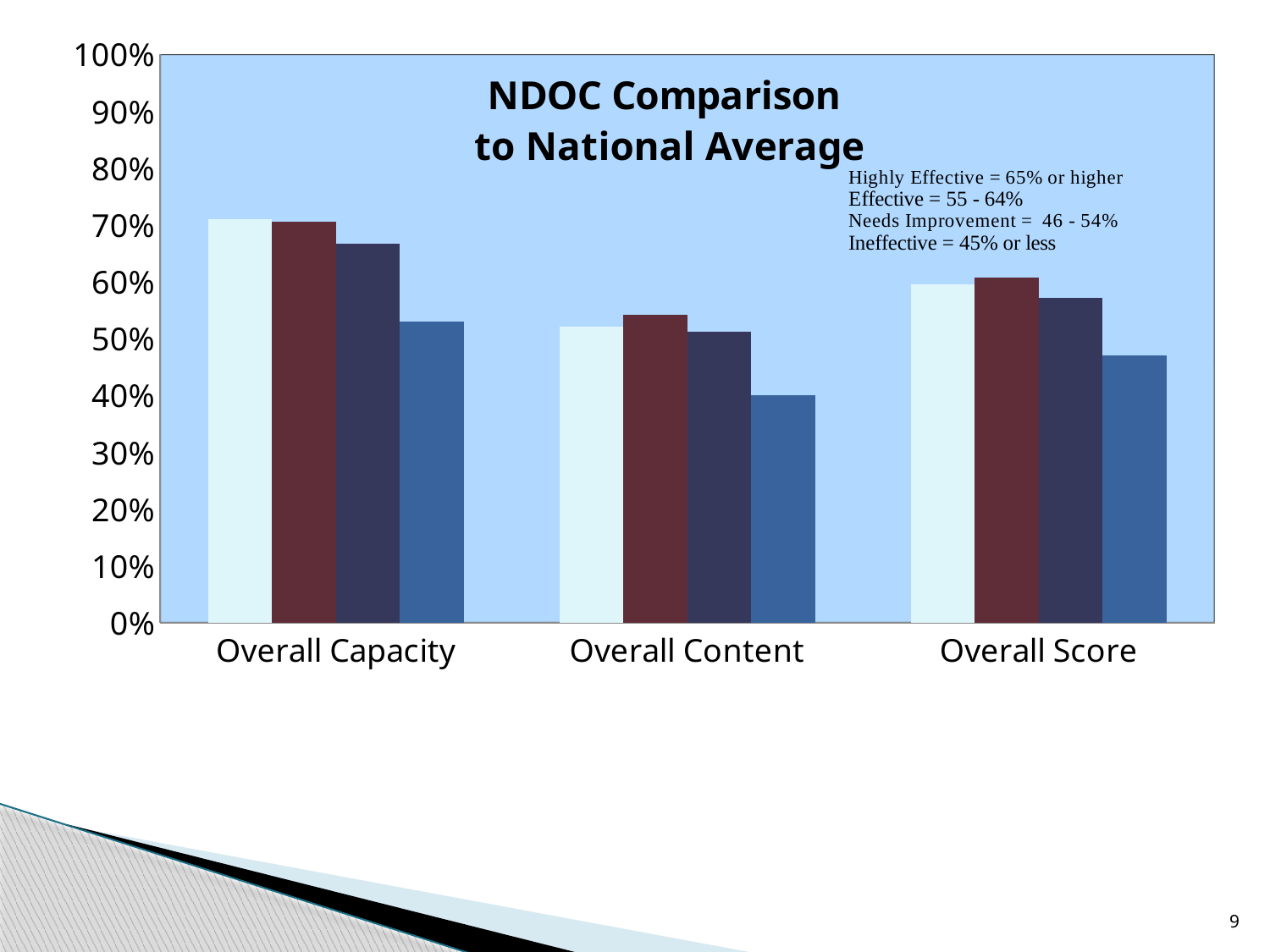
What is the title of the chart? NDOC Comparison to National Average Is the value of the rightmost (blue) bar for Overall Content greater or less than 50%? less What kind of chart is shown on the slide? bar chart For Overall Content, which is larger: the maroon bar or the rightmost (blue) bar? the maroon bar Is the value of the leftmost (lightest) bar for Overall Capacity greater or less than 60%? greater How many bars are plotted for each category? 4 How many categories are shown on the x axis? 3 Is the value of the rightmost (blue) bar for Overall Capacity greater or less than 40%? greater For Overall Capacity, which is larger: the leftmost (lightest) bar or the rightmost (blue) bar? the leftmost (lightest) bar According to the text on the chart, what score range is defined as Highly Effective? 65% or higher In which category is the rightmost (blue) bar the highest? Overall Capacity